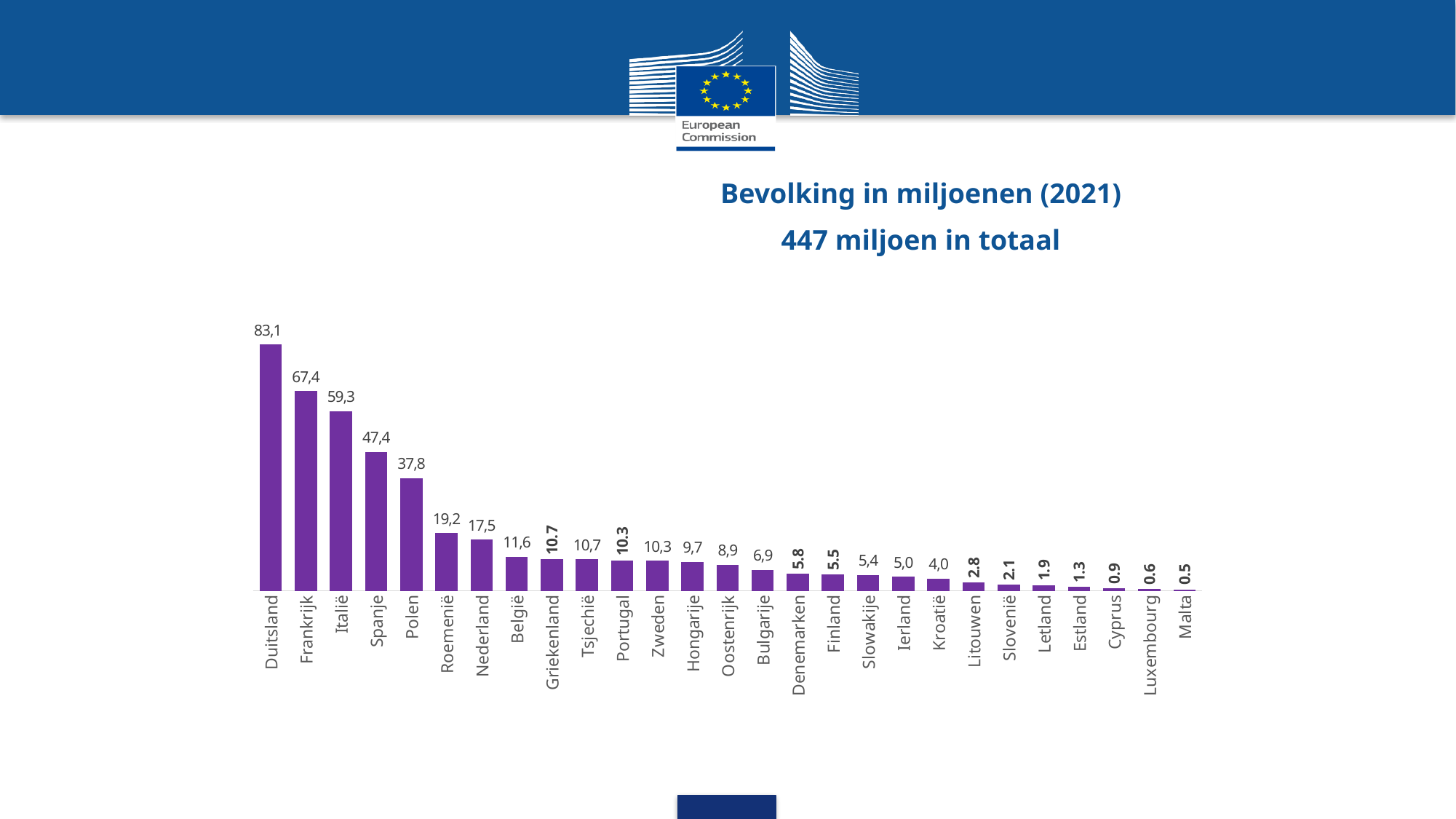
How many countries are shown in the chart? 27 What is the value shown for Malta? 0.5 What is the title of the chart? Bevolking in miljoenen (2021) Which country has the lowest value in the chart? Malta What is the value shown for Duitsland? 83,1 What kind of chart is shown on the slide? Bar chart What is the difference between the values for Spanje and Polen? 9,6 What is the difference between the values for Duitsland and Frankrijk? 15,7 Which has a larger value, Polen or Roemenië? Polen What is the value shown for Nederland? 17,5 Which country has the highest value in the chart? Duitsland What is the value shown for Denemarken? 5.8